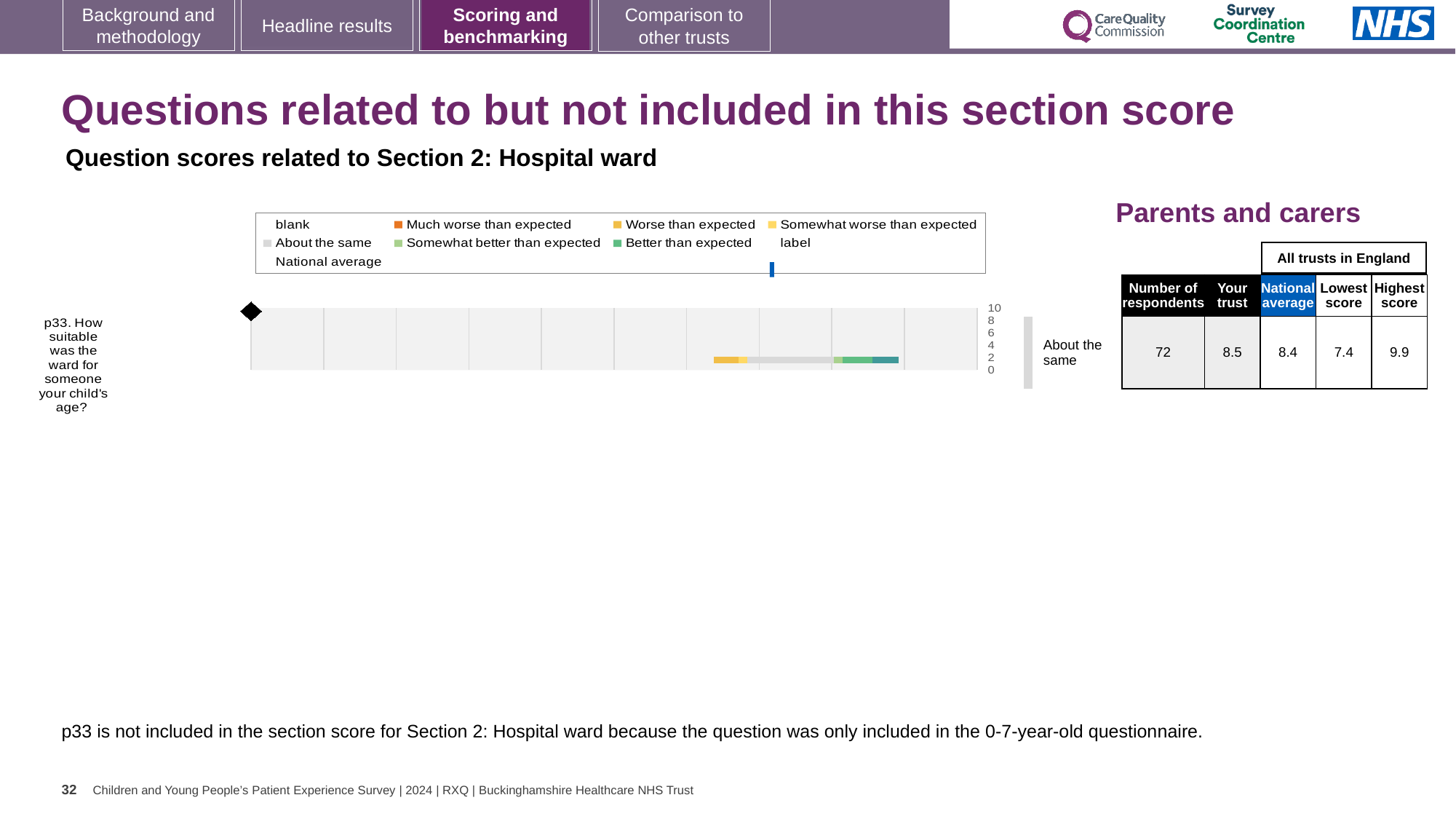
Which question is plotted in the chart? p33. How suitable was the ward for someone your child's age? How many questions (categories) are plotted in the chart? 1 In the table next to the chart, what is the lowest score among all trusts in England for p33? 7.4 In the table next to the chart, what is the national average score for p33? 8.4 In the table next to the chart, what is the number of respondents for p33? 72 In the table next to the chart, what is the highest score among all trusts in England for p33? 9.9 In the table next to the chart, what is the 'Your trust' score for p33? 8.5 What benchmark label is shown to the right of the bar for p33? About the same In the table next to the chart, what is the difference between the highest score and the lowest score for p33? 2.5 What kind of chart is shown on the slide? bar chart What is the highest value shown on the chart's axis? 10 In the table next to the chart, which is larger for p33: the 'Your trust' score or the national average? Your trust